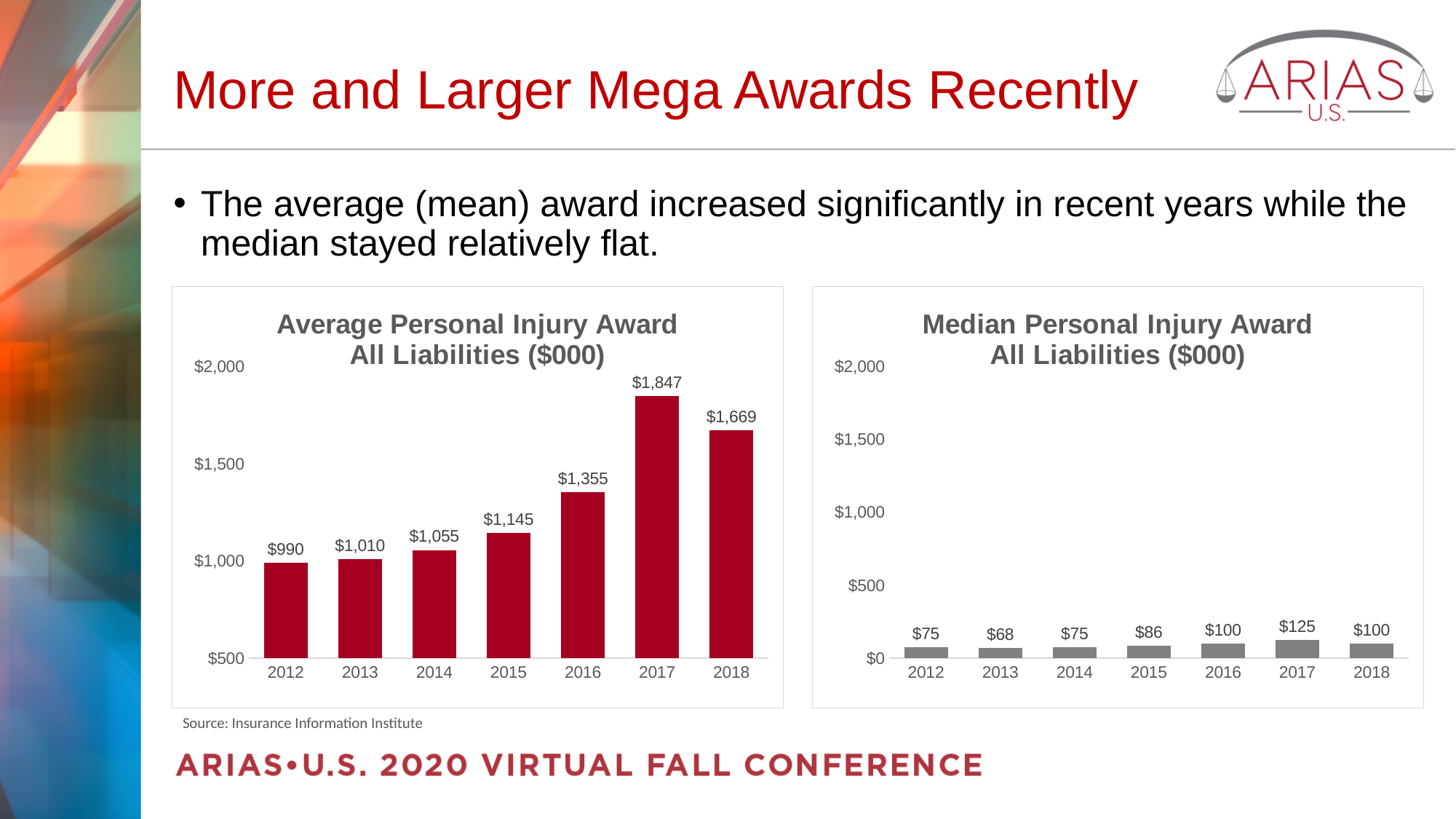
In the Average Personal Injury Award chart, what is the value for 2017? $1,847 In the Median Personal Injury Award chart, which year has the lowest value? 2013 In the Average Personal Injury Award chart, which is larger, the value for 2016 or the value for 2018? 2018 In the Median Personal Injury Award chart, what is the value for 2015? $86 In the Average Personal Injury Award chart, is the value for 2015 greater or less than $1,000? greater What kind of chart is the Average Personal Injury Award chart? bar chart In the Average Personal Injury Award chart, do the values rise or fall from 2012 to 2017? rise In the Median Personal Injury Award chart, what is the difference between the 2017 and 2016 values? $25 What is the source cited below the charts? Insurance Information Institute In the Average Personal Injury Award chart, what is the difference between the 2018 and 2012 values? $679 How many years are shown on the x axis of the Median Personal Injury Award chart? 7 In the Average Personal Injury Award chart, which year has the highest value? 2017